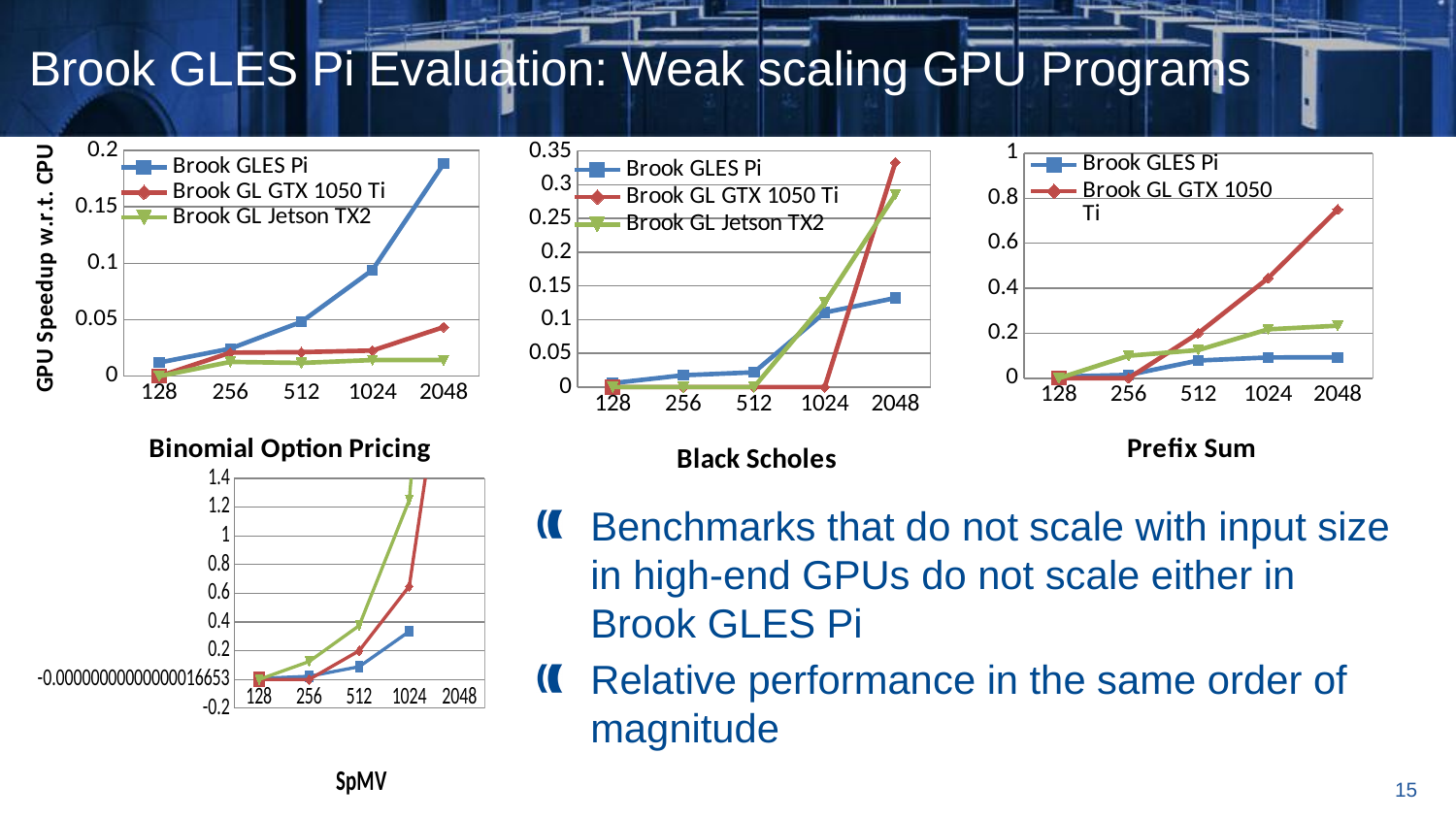
In the Black Scholes chart, is the value for Brook GLES Pi at 2048 greater or less than 0.1? greater In the Prefix Sum chart, is the value for Brook GL GTX 1050 Ti at 2048 greater or less than 0.6? greater How many series does the legend of the Binomial Option Pricing chart list? 3 How many series does the legend of the Prefix Sum chart list? 2 In the Prefix Sum chart, does the Brook GL GTX 1050 Ti series rise or fall from 128 to 2048? rise In the Binomial Option Pricing chart, is the value for Brook GLES Pi at 2048 greater or less than 0.15? greater What kind of chart is the Binomial Option Pricing chart? line chart In the Black Scholes chart, which series has the highest value at 2048? Brook GL GTX 1050 Ti In the Binomial Option Pricing chart, which series has the highest value at 2048? Brook GLES Pi How many x-axis categories does the SpMV chart show? 5